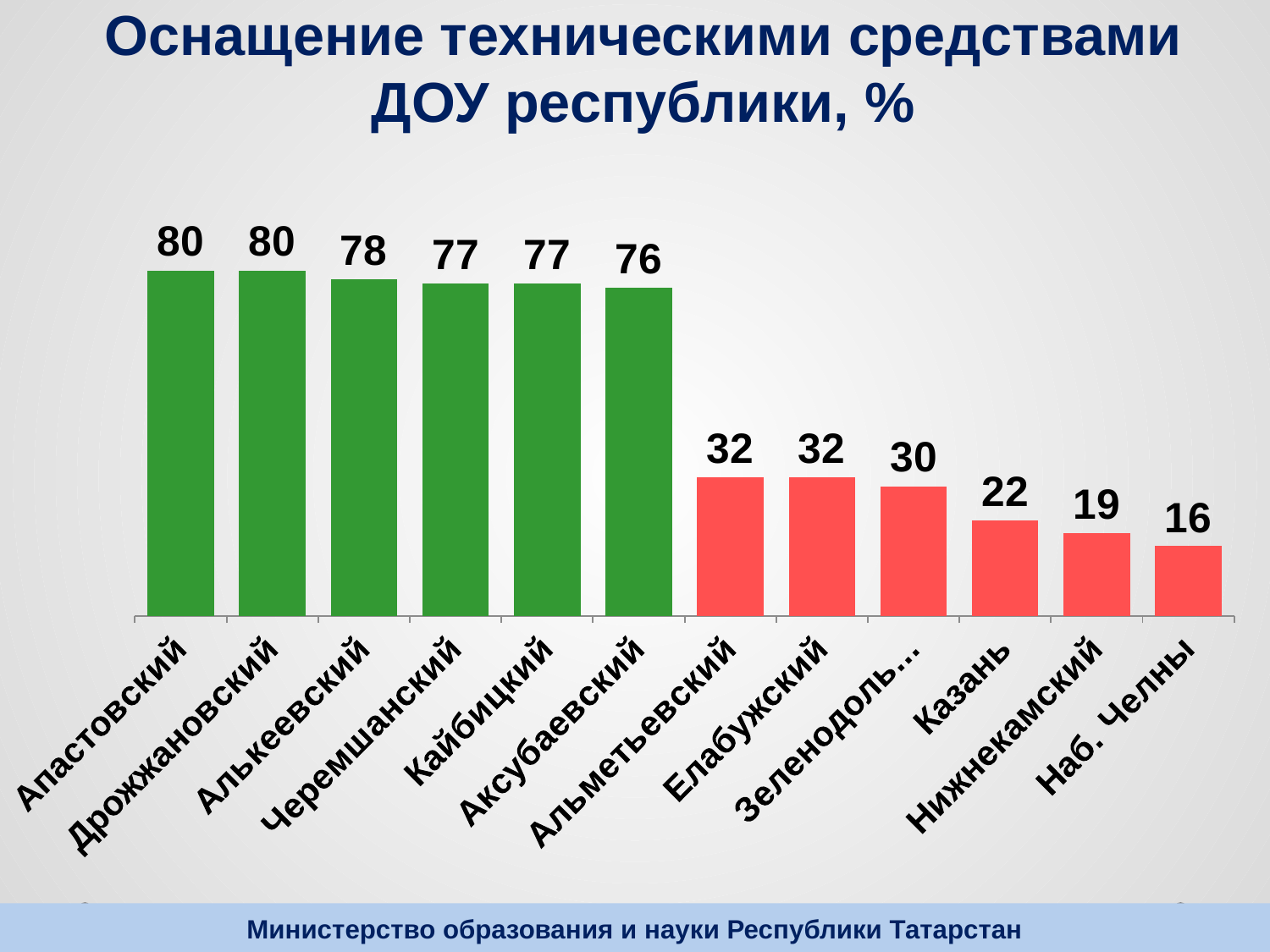
What kind of chart is shown on the slide? bar chart What is the value for Казань? 22 Which category has the lowest value? Наб. Челны What colour are the bars for the six leftmost categories? green What is the value for Апастовский? 80 How many categories are shown in the chart? 12 Which is larger, the value for Черемшанский or the value for Елабужский? Черемшанский What is the value for Нижнекамский? 19 What is the value for Алькеевский? 78 What is the difference between the values for Казань and Наб. Челны? 6 What is the difference between the values for Аксубаевский and Альметьевский? 44 Do the values rise or fall from left to right along the x axis? fall